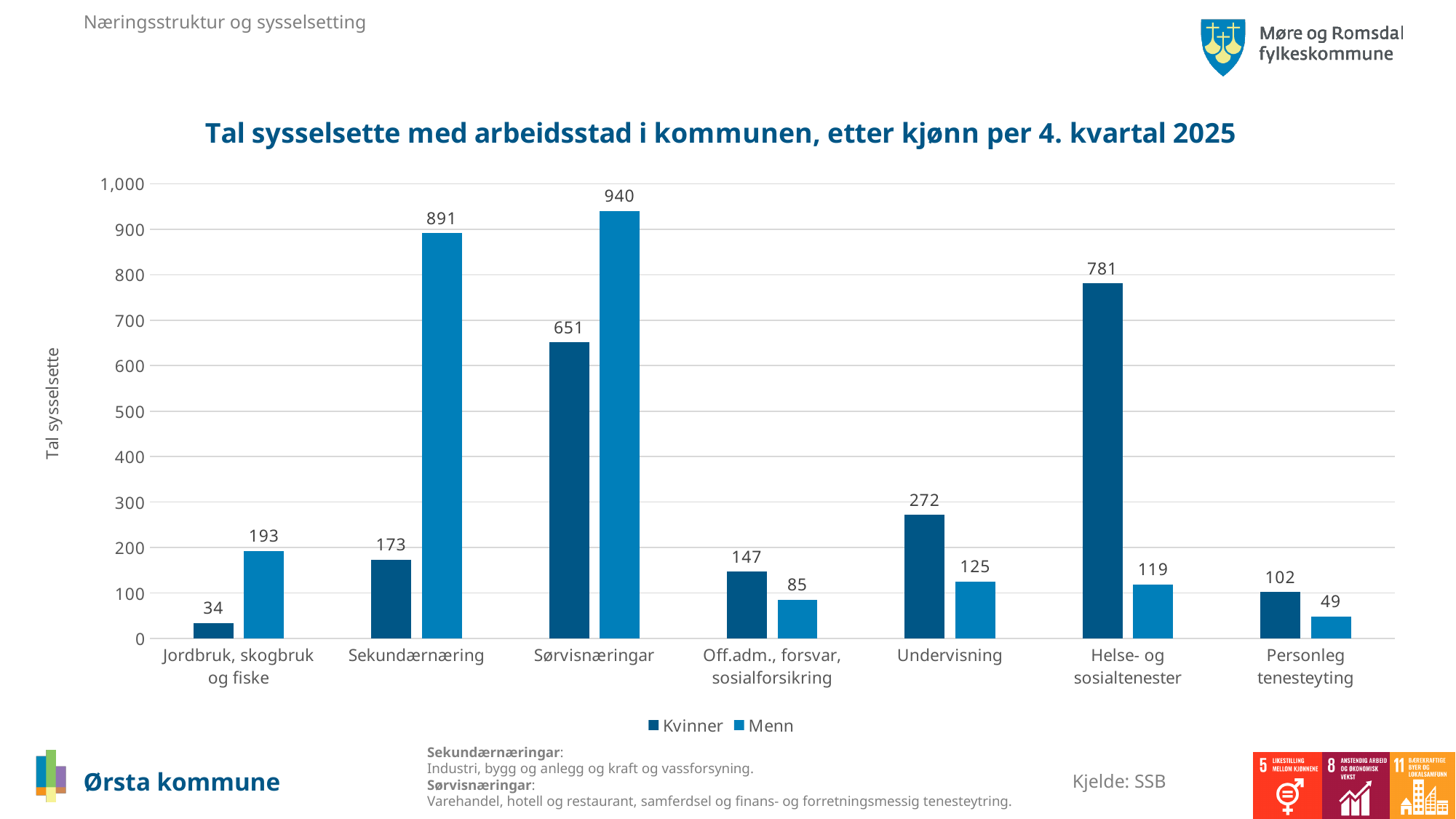
How many categories are shown on the x axis? 7 What is the value for Menn in Sekundærnæring? 891 What kind of chart is shown? bar chart Is the value for Menn in Personleg tenesteyting greater or less than 100? less Which category has the lowest value for Kvinner? Jordbruk, skogbruk og fiske What is the title of the chart? Tal sysselsette med arbeidsstad i kommunen, etter kjønn per 4. kvartal 2025 Which is larger in Undervisning: Kvinner or Menn? Kvinner How many series does the legend list? 2 Which category has the highest value for Menn? Sørvisnæringar What is the value for Kvinner in Helse- og sosialtenester? 781 What is the difference between Menn and Kvinner in Sørvisnæringar? 289 What is the value for Kvinner in Jordbruk, skogbruk og fiske? 34